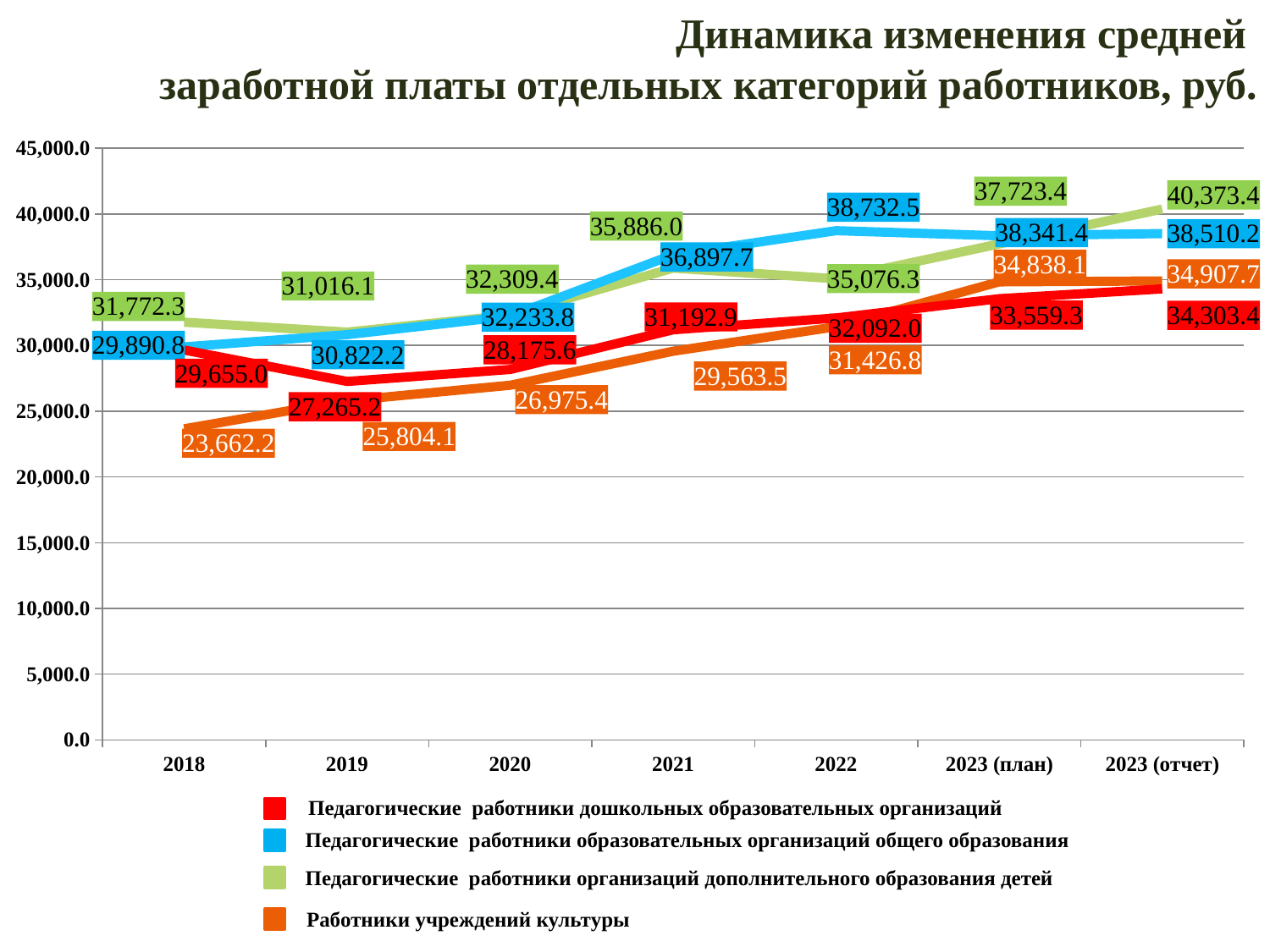
What is the value for Педагогические работники организаций дополнительного образования детей in 2023 (отчет)? 40,373.4 How many series does the legend list? 4 Is the value for Работники учреждений культуры in 2019 greater or less than 30,000.0? less What kind of chart is shown on the slide? line chart Which is larger in 2021: the value for Педагогические работники образовательных организаций общего образования or for Педагогические работники организаций дополнительного образования детей? Педагогические работники образовательных организаций общего образования What is the value for Педагогические работники образовательных организаций общего образования in 2022? 38,732.5 What is the value for Работники учреждений культуры in 2018? 23,662.2 Which series has the highest value in 2023 (отчет)? Педагогические работники организаций дополнительного образования детей What is the difference between the 2023 (отчет) and 2018 values for Работники учреждений культуры? 11,245.5 Which year has the lowest value for Педагогические работники дошкольных образовательных организаций? 2019 How many categories are shown on the x axis? 7 Does the value for Работники учреждений культуры rise or fall from 2018 to 2023 (отчет)? rise